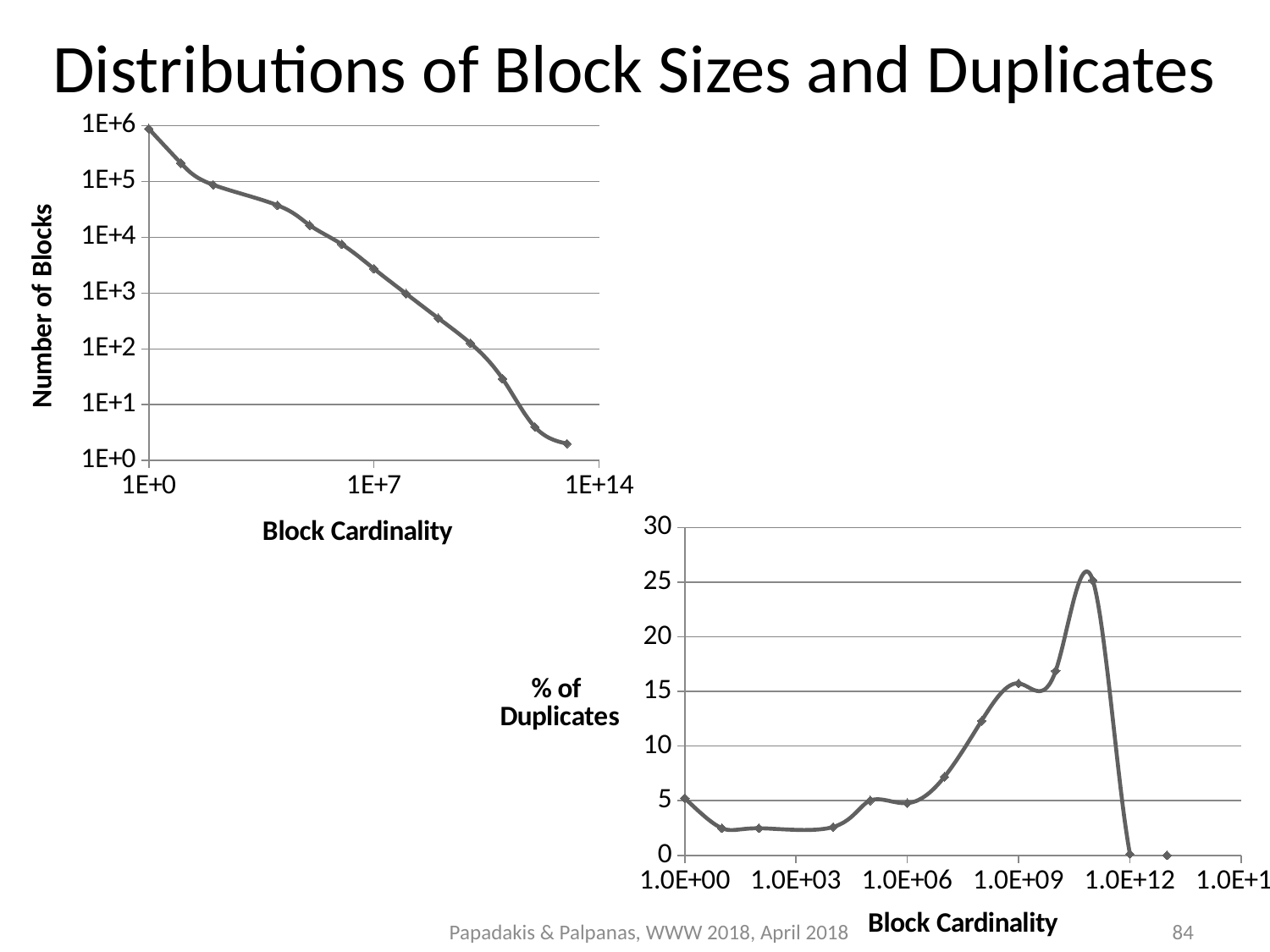
What is the x-axis title of the bottom-right chart? Block Cardinality In the top-left chart, which Block Cardinality has the highest Number of Blocks? 1E+0 What kind of chart is the bottom-right chart with the y-axis '% of Duplicates'? line chart In the bottom-right chart (% of Duplicates), is the value at Block Cardinality 1.0E+09 greater or less than 15? greater What kind of chart is the top-left chart titled with the y-axis 'Number of Blocks'? line chart In the top-left chart (Number of Blocks), is the value at the largest Block Cardinality greater or less than 1E+1? less In the bottom-right chart (% of Duplicates), is the peak value greater or less than 20? greater What is the y-axis title of the top-left chart? Number of Blocks In the top-left chart (Number of Blocks), do the values rise or fall as Block Cardinality increases? fall